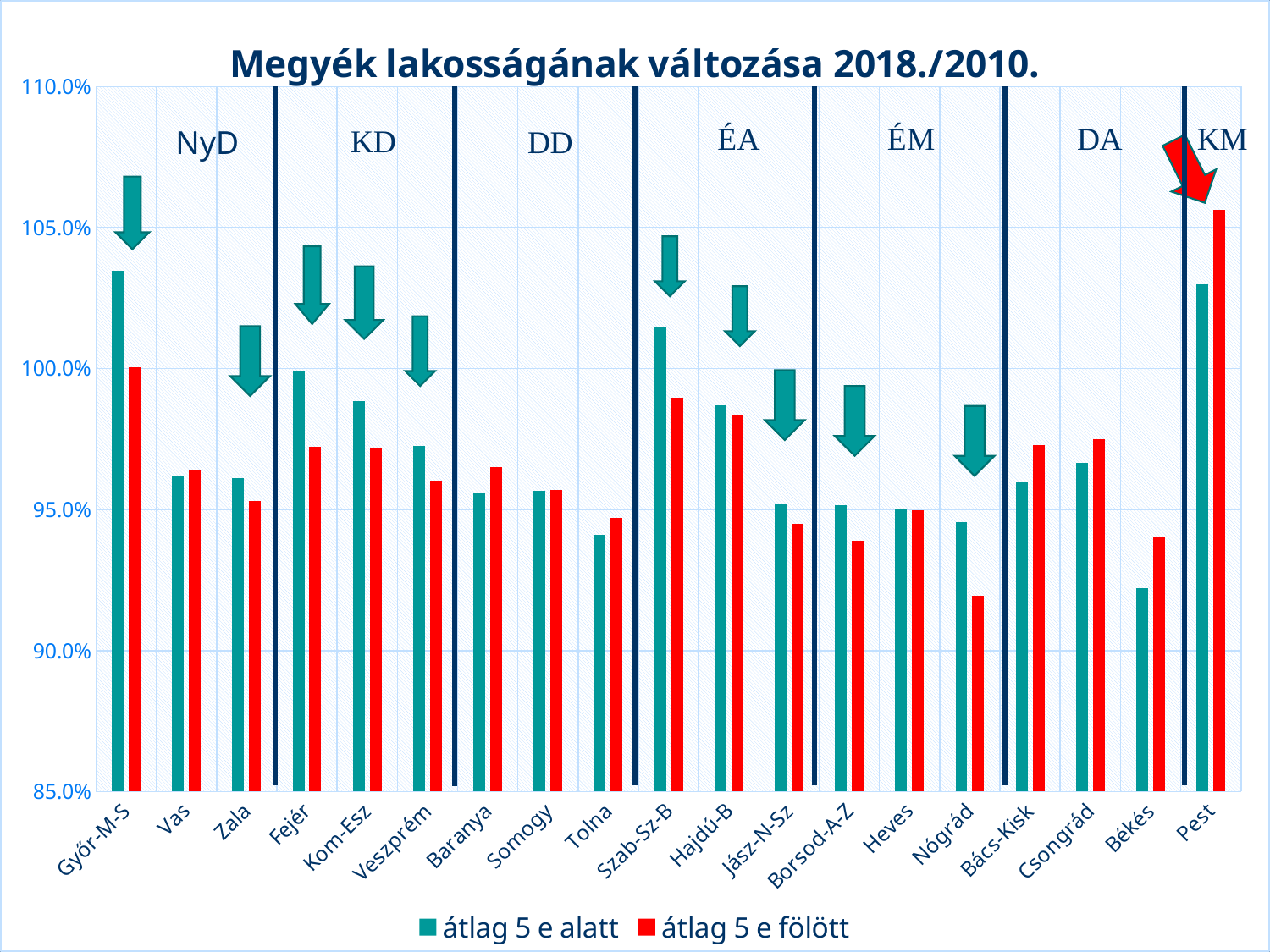
What type of chart is shown on the slide? bar chart Which county has the highest value for the 'átlag 5 e fölött' series? Pest For Fejér, which series has the larger value: 'átlag 5 e alatt' or 'átlag 5 e fölött'? átlag 5 e alatt How many series does the legend list? 2 Is the 'átlag 5 e alatt' value for Tolna greater or less than 95.0%? less What is the title of the chart? Megyék lakosságának változása 2018./2010. Is the 'átlag 5 e fölött' value for Pest greater or less than 105.0%? greater How many counties (categories) are shown on the x axis? 19 Which county has the lowest value for the 'átlag 5 e fölött' series? Nógrád Which county has the lowest value for the 'átlag 5 e alatt' series? Békés For Pest, which series has the larger value: 'átlag 5 e alatt' or 'átlag 5 e fölött'? átlag 5 e fölött Is the 'átlag 5 e alatt' value for Győr-M-S greater or less than 100.0%? greater